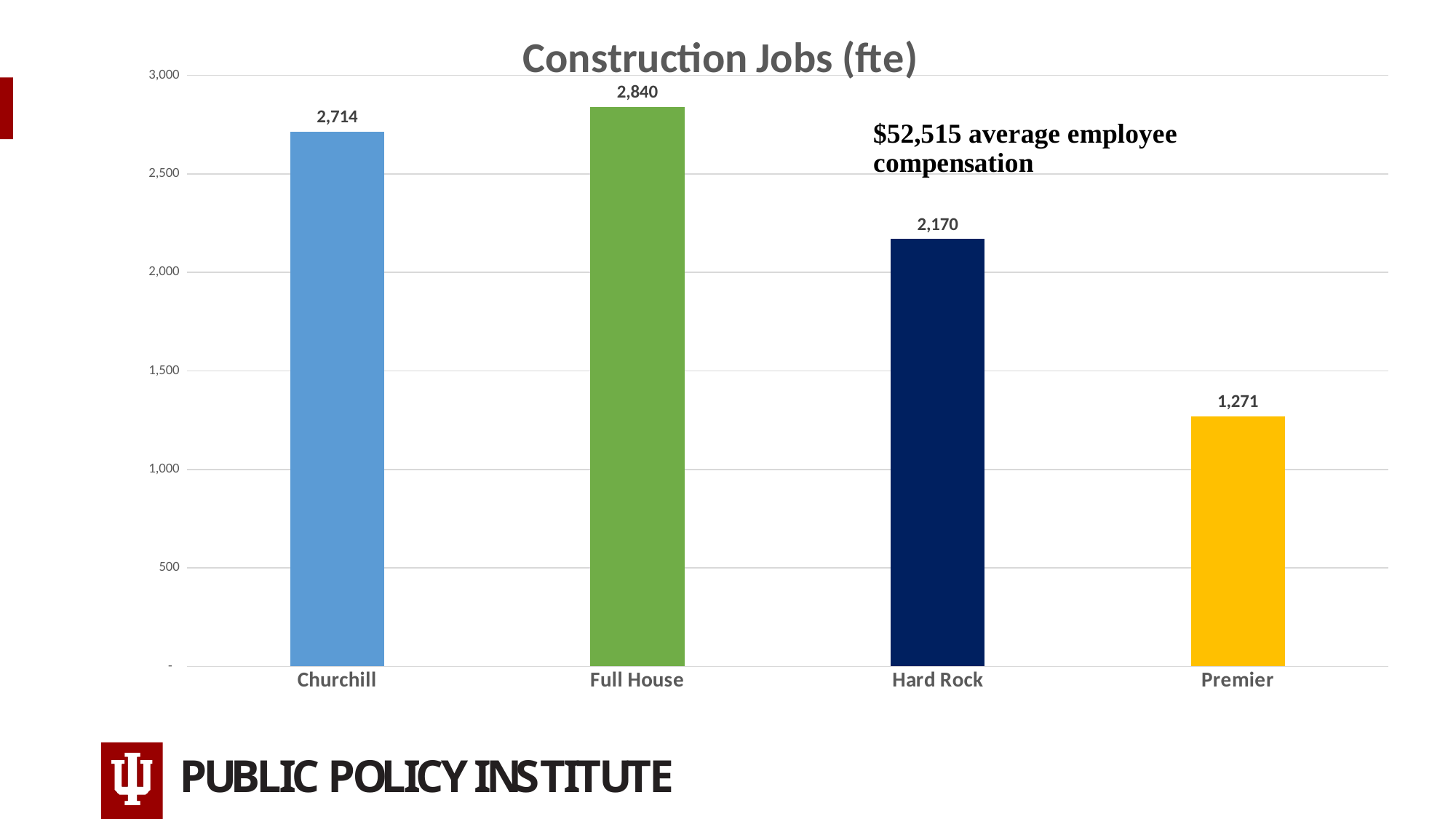
Which category has the highest value? Full House What kind of chart is this? Bar chart What is the value for Full House? 2,840 What is the title of the chart? Construction Jobs (fte) What is the value for Churchill? 2,714 Which category has the lowest value? Premier How many categories are shown in the chart? 4 What is the value for Hard Rock? 2,170 What is the difference between the values for Full House and Churchill? 126 Which is larger, the value for Churchill or the value for Hard Rock? Churchill What is the difference between the values for Hard Rock and Premier? 899 What is the value for Premier? 1,271